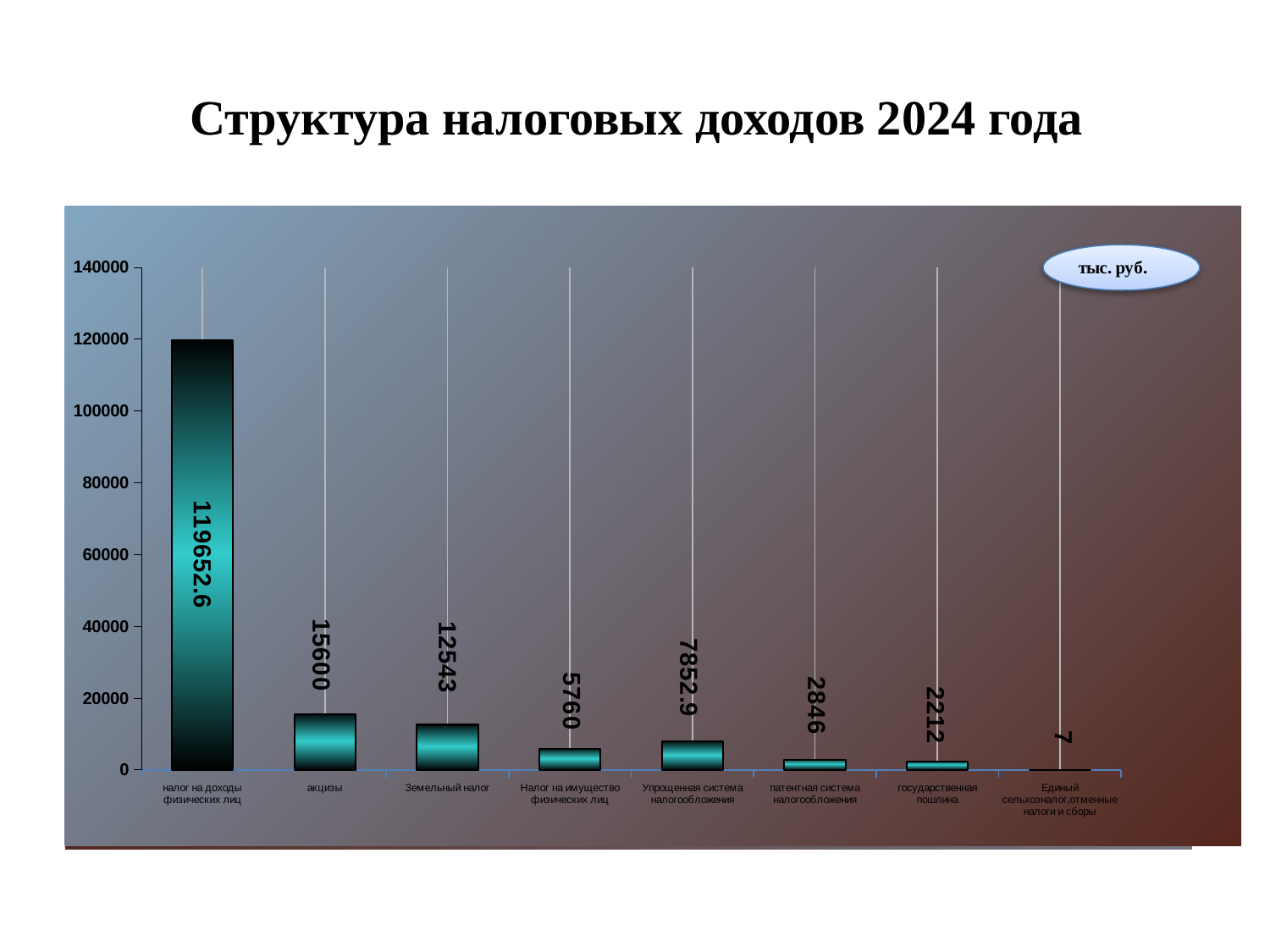
What is the value for налог на доходы физических лиц? 119652.6 What kind of chart is shown on the slide? bar chart Which category has the lowest value? Единый сельхозналог,отменные налоги и сборы What is the difference between the values for акцизы and Земельный налог? 3057 How many categories are shown on the x axis? 8 What unit is indicated in the label at the top right of the chart? тыс. руб. What is the value for государственная пошлина? 2212 What is the value for Упрощенная система налогообложения? 7852.9 Is the value for налог на доходы физических лиц greater or less than 100000? greater Which is larger, the value for Налог на имущество физических лиц or the value for Упрощенная система налогообложения? Упрощенная система налогообложения Which category has the highest value? налог на доходы физических лиц What is the value for акцизы? 15600